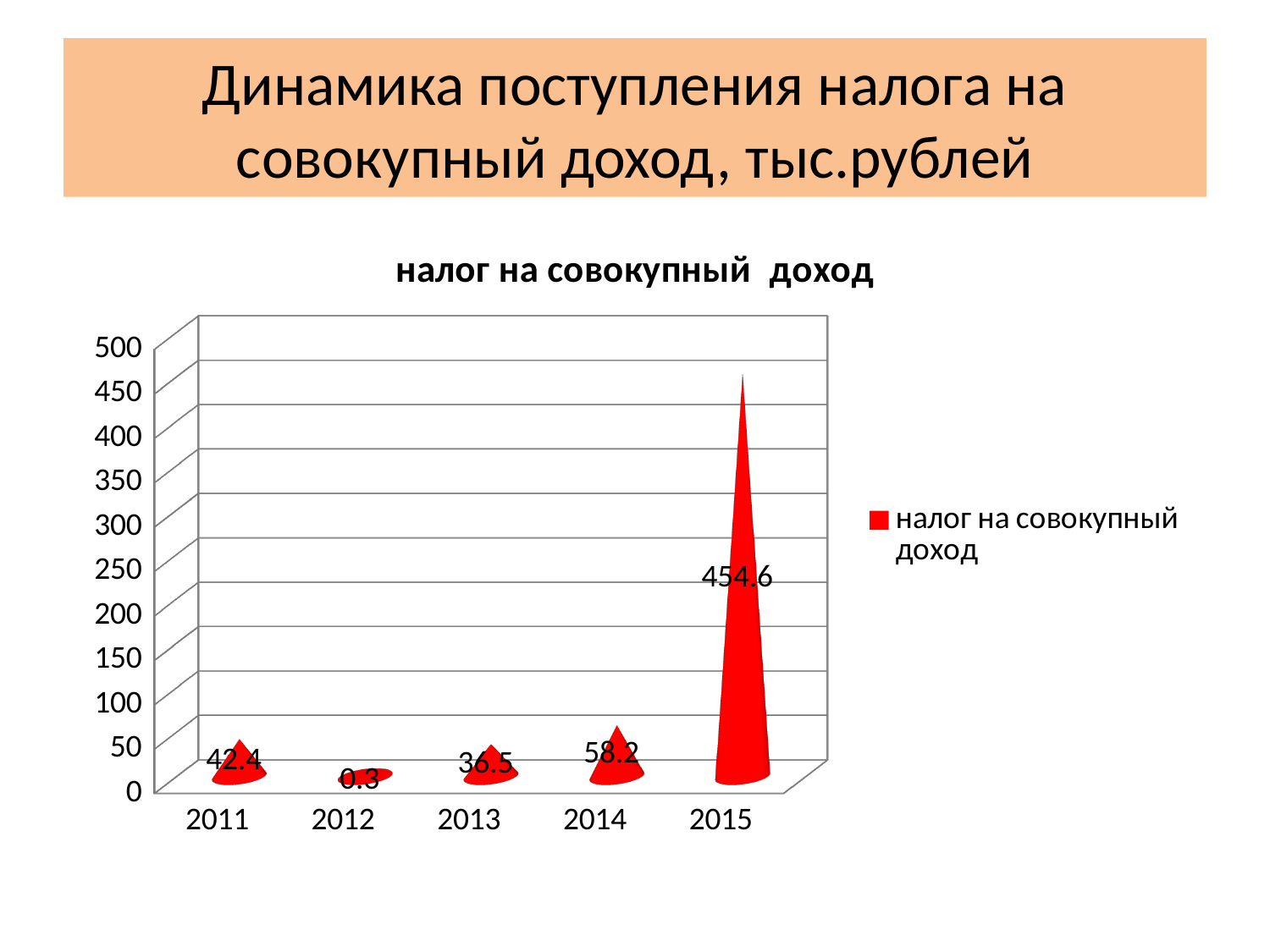
What is the title of the chart? налог на совокупный доход What is the value for 2012 in the chart? 0.3 What is the value for 2015 in the chart? 454.6 What is the difference between the values for 2011 and 2013? 5.9 How many years are shown on the x axis of the chart? 5 What is the difference between the values for 2015 and 2014? 396.4 How many series does the legend list? 1 Which year has the lowest value in the chart? 2012 Which year has the highest value in the chart? 2015 What is the value for 2011 in the chart? 42.4 Which is larger, the value for 2011 or the value for 2013? 2011 What is the value for 2014 in the chart? 58.2